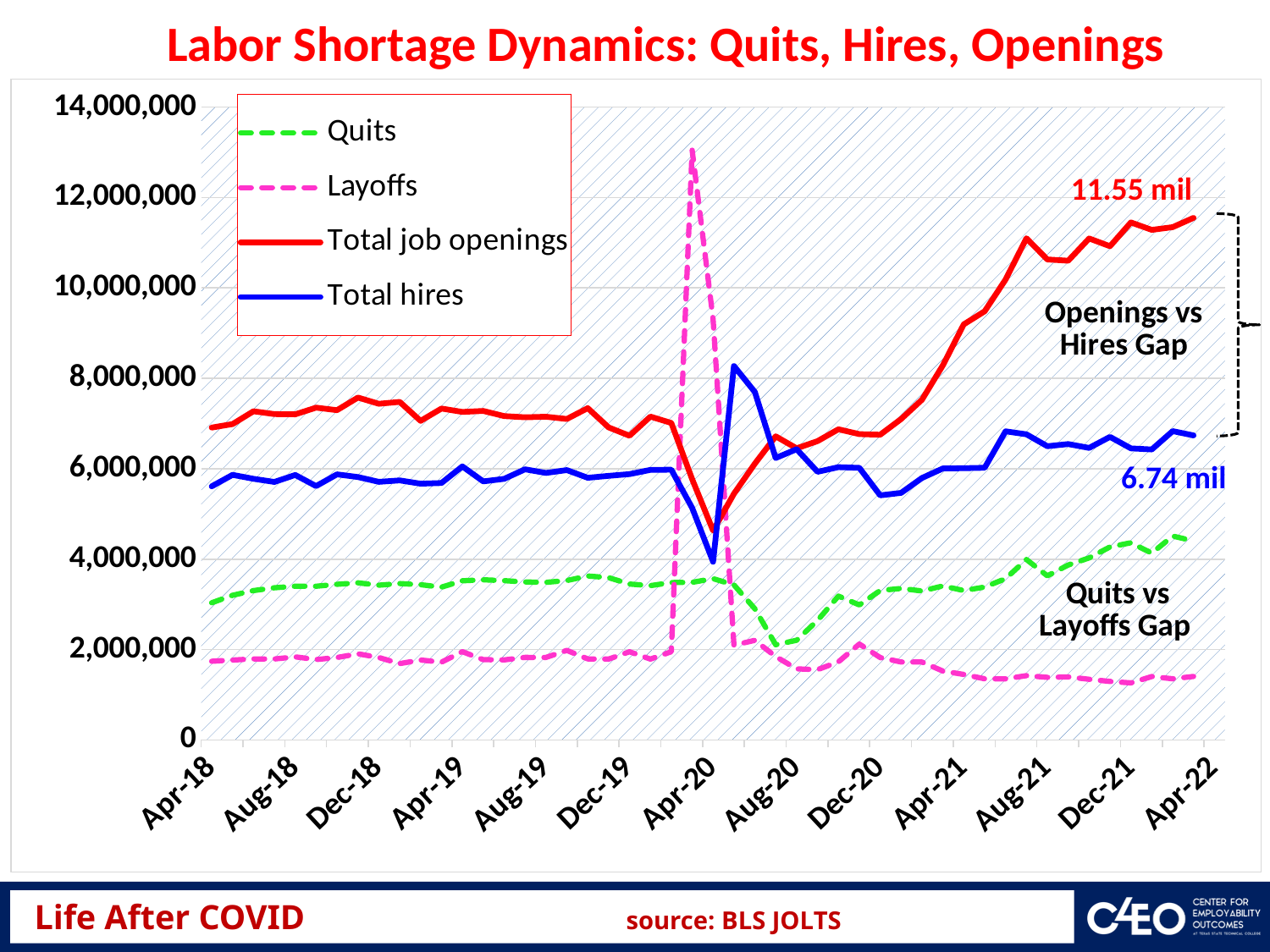
What is the difference between Total job openings and Total hires at Apr-22? 4.81 mil What kind of chart is shown on the slide? line chart What is the value of Total hires at Apr-22? 6.74 mil Is the peak value for Layoffs greater or less than 12,000,000? greater What is the value of Total job openings at Apr-22? 11.55 mil How many series does the legend list? 4 At Apr-22, which is larger, Total job openings or Total hires? Total job openings Do Total job openings rise or fall from Dec-20 to Apr-22? rise What is the title of the chart? Labor Shortage Dynamics: Quits, Hires, Openings Which series reaches the highest value anywhere on the chart? Layoffs Is the value for Quits at Apr-18 greater or less than 4,000,000? less Which series has the lowest value at Apr-22? Layoffs